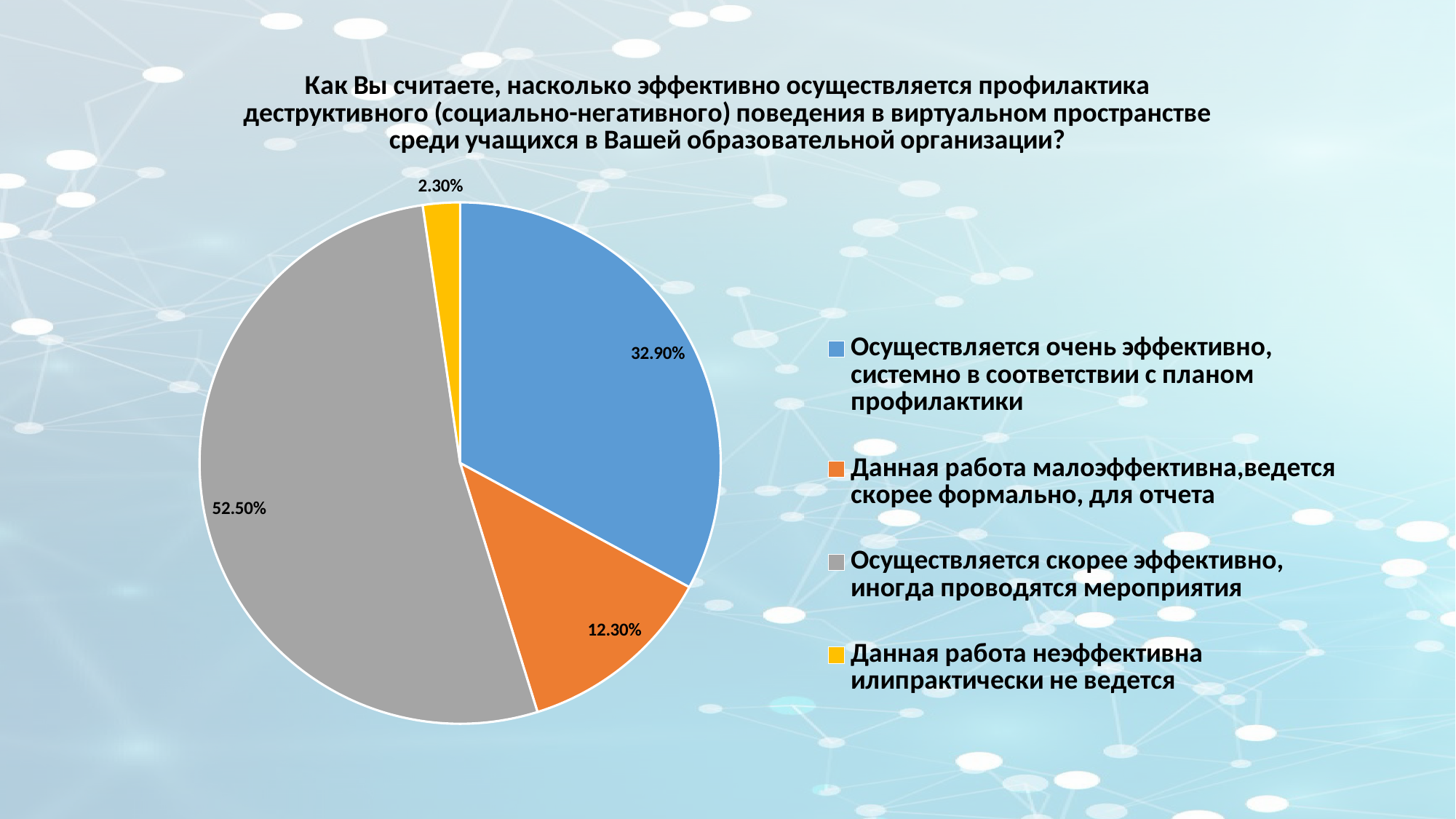
How many entries does the legend list? 4 What colour is the slice for "Осуществляется скорее эффективно, иногда проводятся мероприятия"? Gray What share of respondents answered "Данная работа неэффективна или практически не ведется"? 2.30% What is the difference in percentage points between the "скорее эффективно" slice and the "очень эффективно" slice? 19.60 percentage points What type of chart is shown on the slide? Pie chart Which answer option has the largest share of the pie? Осуществляется скорее эффективно, иногда проводятся мероприятия What share of respondents answered "Осуществляется скорее эффективно, иногда проводятся мероприятия"? 52.50% Which is larger: the share for "Данная работа малоэффективна" or the share for "Данная работа неэффективна"? Данная работа малоэффективна What share of respondents answered "Осуществляется очень эффективно, системно в соответствии с планом профилактики"? 32.90% Which answer option has the smallest share of the pie? Данная работа неэффективна или практически не ведется How many slices does the pie chart have? 4 What share of respondents answered "Данная работа малоэффективна, ведется скорее формально, для отчета"? 12.30%